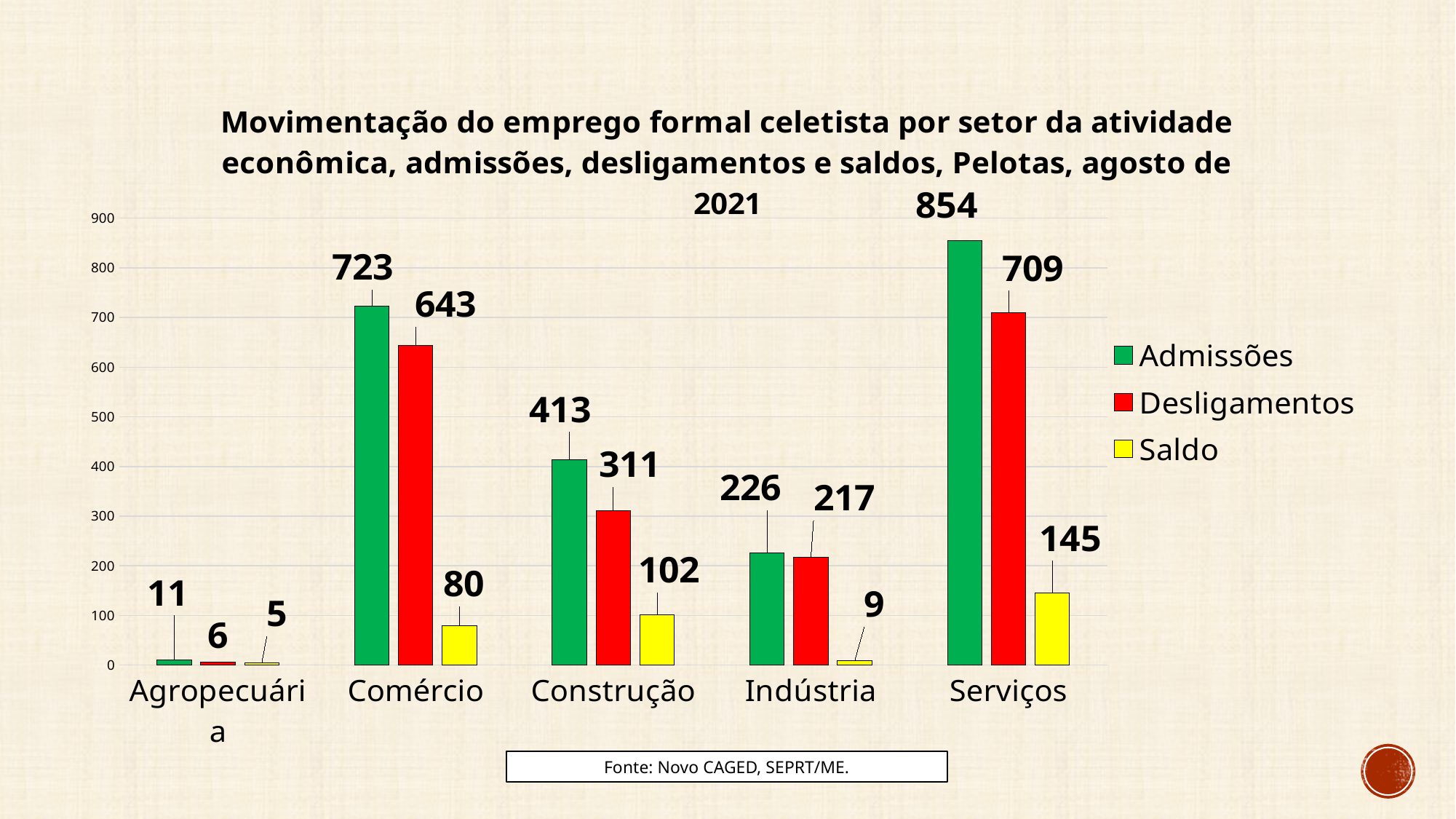
How many sectors are shown on the x axis? 5 Is the Admissões value for Serviços greater or less than 800? greater What colour represents the Saldo series in the legend? Yellow What is the value of Admissões for Comércio? 723 How many series does the legend list? 3 What is the value of Desligamentos for Serviços? 709 What is the difference between Admissões and Desligamentos for Construção? 102 What is the Saldo value for Indústria? 9 Which sector has the highest Admissões value? Serviços Which sector has the lowest Desligamentos value? Agropecuária What kind of chart is shown on the slide? Bar chart Which is larger: the Saldo for Comércio or the Saldo for Serviços? Saldo for Serviços